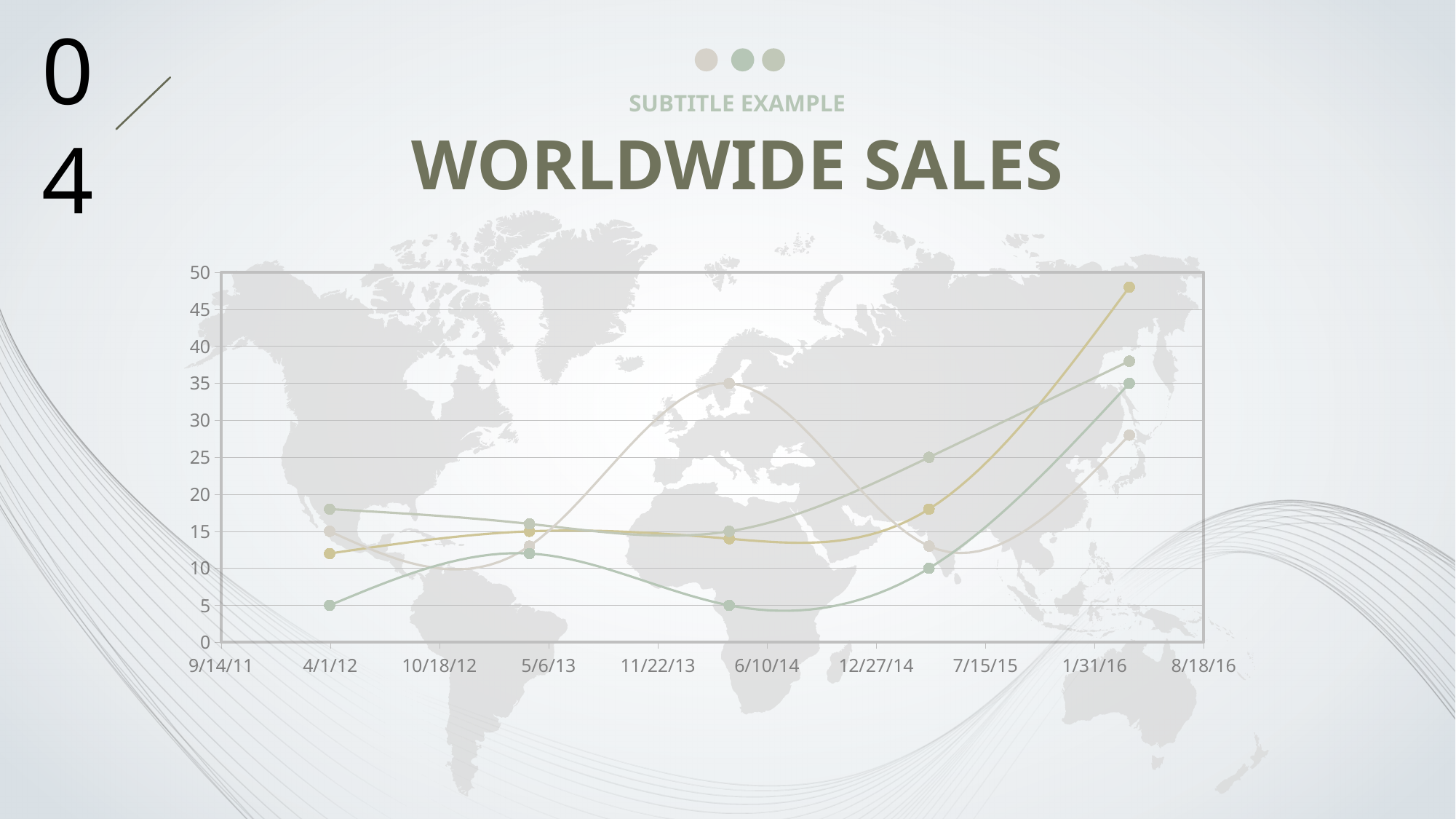
What is the first date label on the x axis of the chart? 9/14/11 Is the lowest plotted point on the chart greater or less than 10? less Do the lines on the chart rise or fall between the 7/15/15 and 1/31/16 labels? rise How many data points does each line on the chart have? 5 How many date labels are shown on the x axis of the chart? 10 What is the highest value shown on the y axis of the chart? 50 Is the highest plotted point on the chart greater or less than 45? greater Is the final point of the yellow line greater or less than 40? greater How many lines are plotted on the chart? 4 What is the title of the chart on the slide? WORLDWIDE SALES What type of chart is shown on the slide? line chart